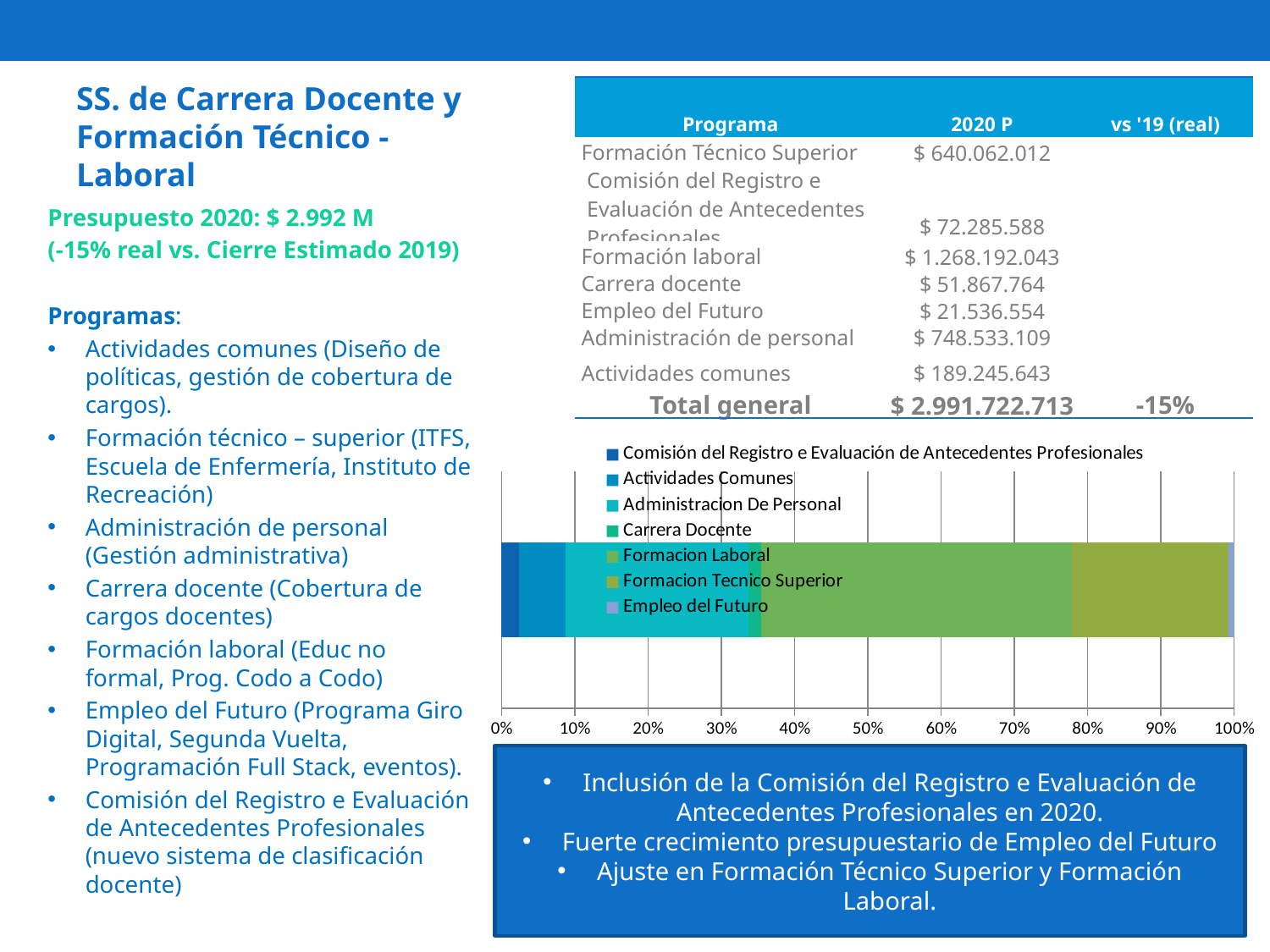
Is the share of the bar for Formacion Laboral greater or less than 30%? greater How many series does the chart legend list? 7 Is the share of the bar for Empleo del Futuro greater or less than 10%? less How many bars are plotted in the chart? 1 Which takes a larger share of the bar, Administracion De Personal or Actividades Comunes? Administracion De Personal What kind of chart is shown on the slide? Stacked bar chart Is the share of the bar for Administracion De Personal greater or less than 20%? greater Which series occupies the largest share of the stacked bar? Formacion Laboral What is the first entry listed in the chart legend? Comisión del Registro e Evaluación de Antecedentes Profesionales Which takes a larger share of the bar, Formacion Laboral or Formacion Tecnico Superior? Formacion Laboral